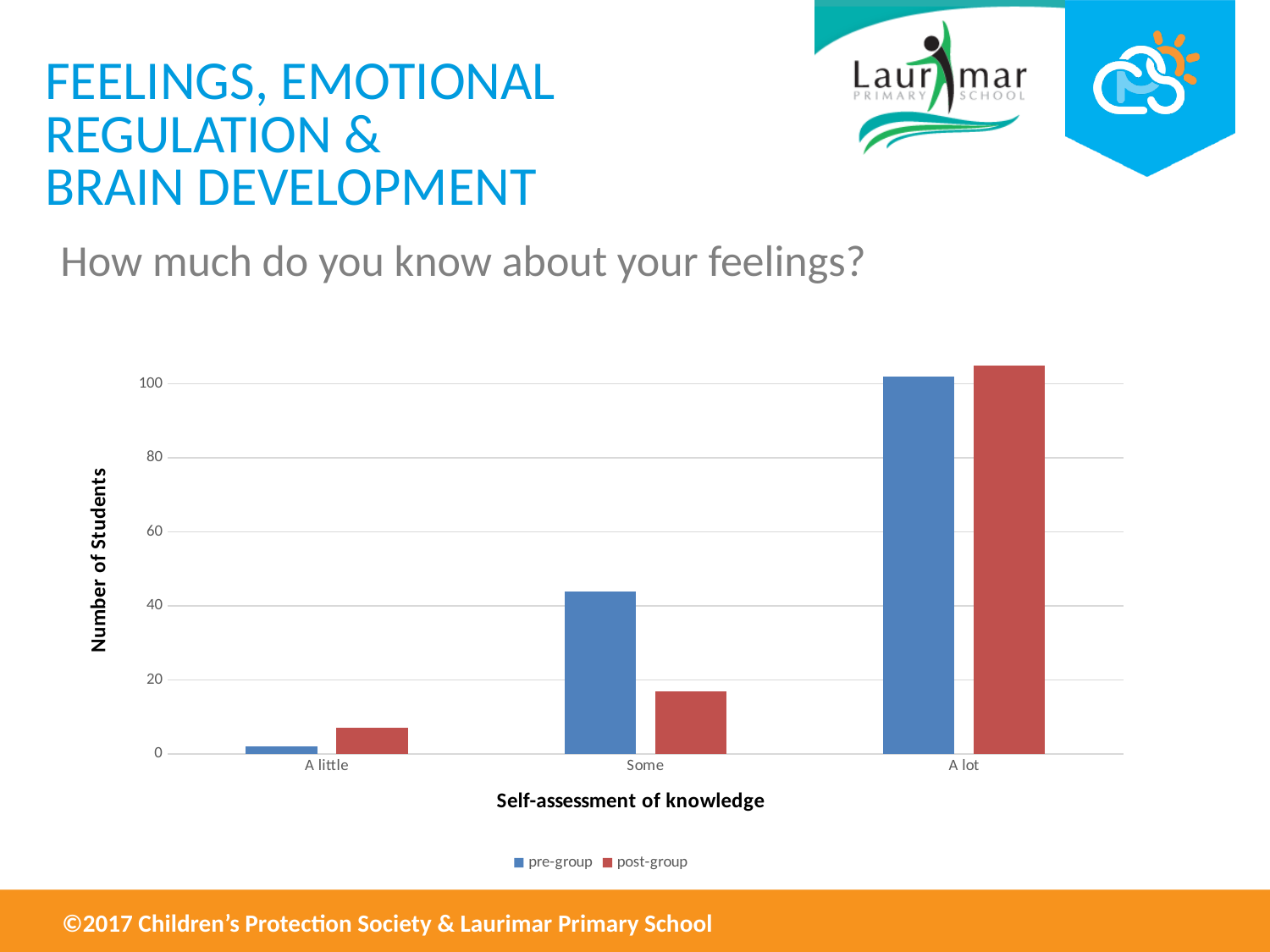
What kind of chart is shown on the slide? bar chart How many categories are shown on the x axis of the chart? 3 Is the pre-group value for 'Some' greater or less than 40? greater What is the title of the chart's vertical axis? Number of Students Which category has the lowest post-group value? A little Is the post-group value for 'Some' greater or less than 20? less Which category has the highest pre-group value? A lot Do the pre-group values rise or fall moving from 'A little' to 'A lot' along the x axis? rise For the 'Some' category, which is larger: the pre-group value or the post-group value? pre-group For the 'A little' category, which is larger: the pre-group value or the post-group value? post-group Is the post-group value for 'A lot' greater or less than 100? greater How many series does the chart's legend list? 2